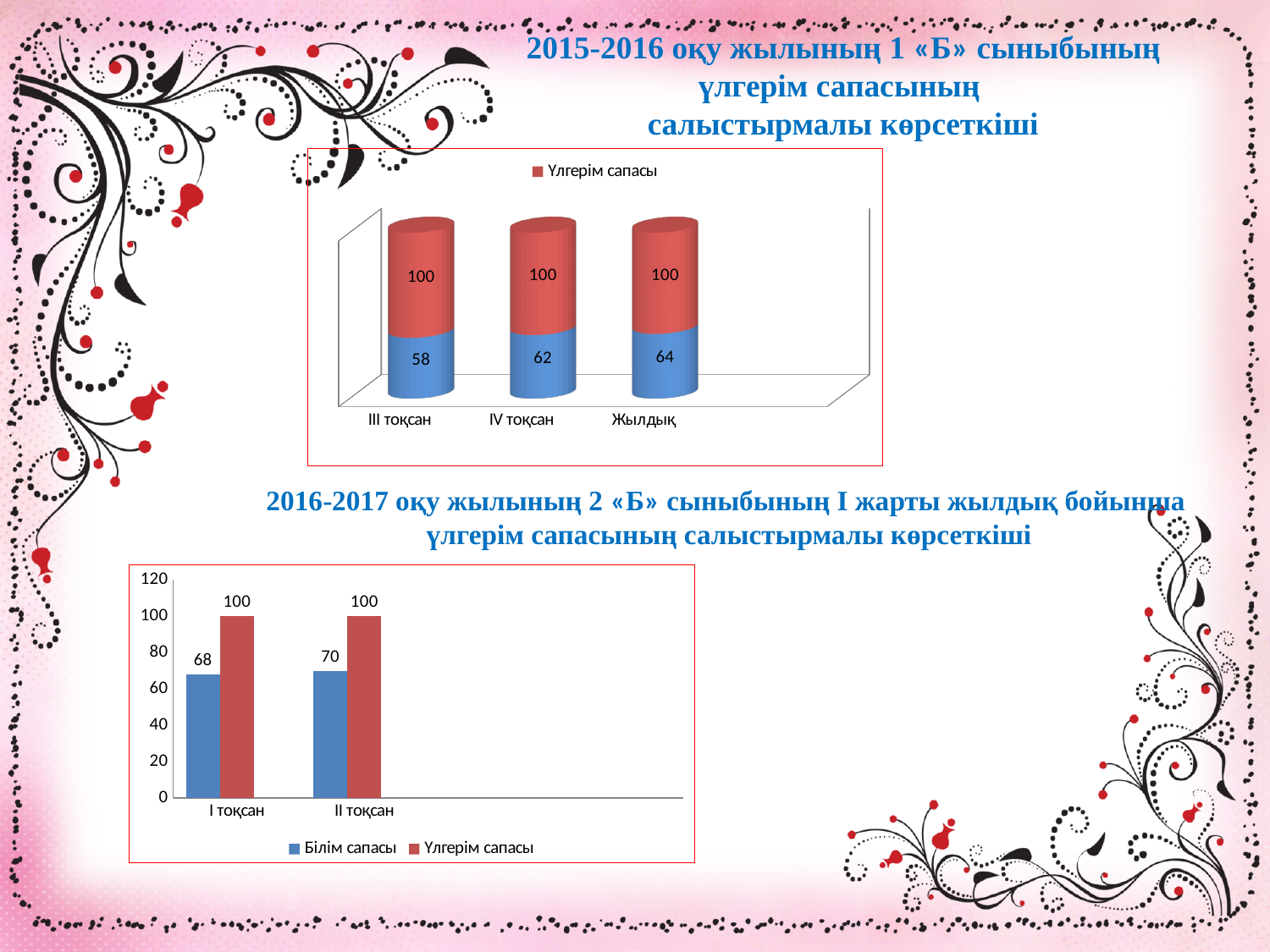
In the bottom chart, what is the difference between Білім сапасы for II тоқсан and I тоқсан? 2 In the bottom chart, what is the value of Білім сапасы for II тоқсан? 70 In the top chart, which category has the lowest blue segment value? III тоқсан What kind of chart is the bottom chart? bar chart In the top chart, what is the value of the blue segment for III тоқсан? 58 In the top chart, how many categories are shown on the x axis? 3 In the top chart, what is the value of the blue segment for Жылдық? 64 In the top chart, do the blue segment values rise or fall from III тоқсан to Жылдық? rise In the top chart, what is the value of the red segment for IV тоқсан? 100 In the bottom chart, how many series does the legend list? 2 In the bottom chart, what is the value of Үлгерім сапасы for I тоқсан? 100 In the top chart, what is the difference between the blue segment values for Жылдық and III тоқсан? 6